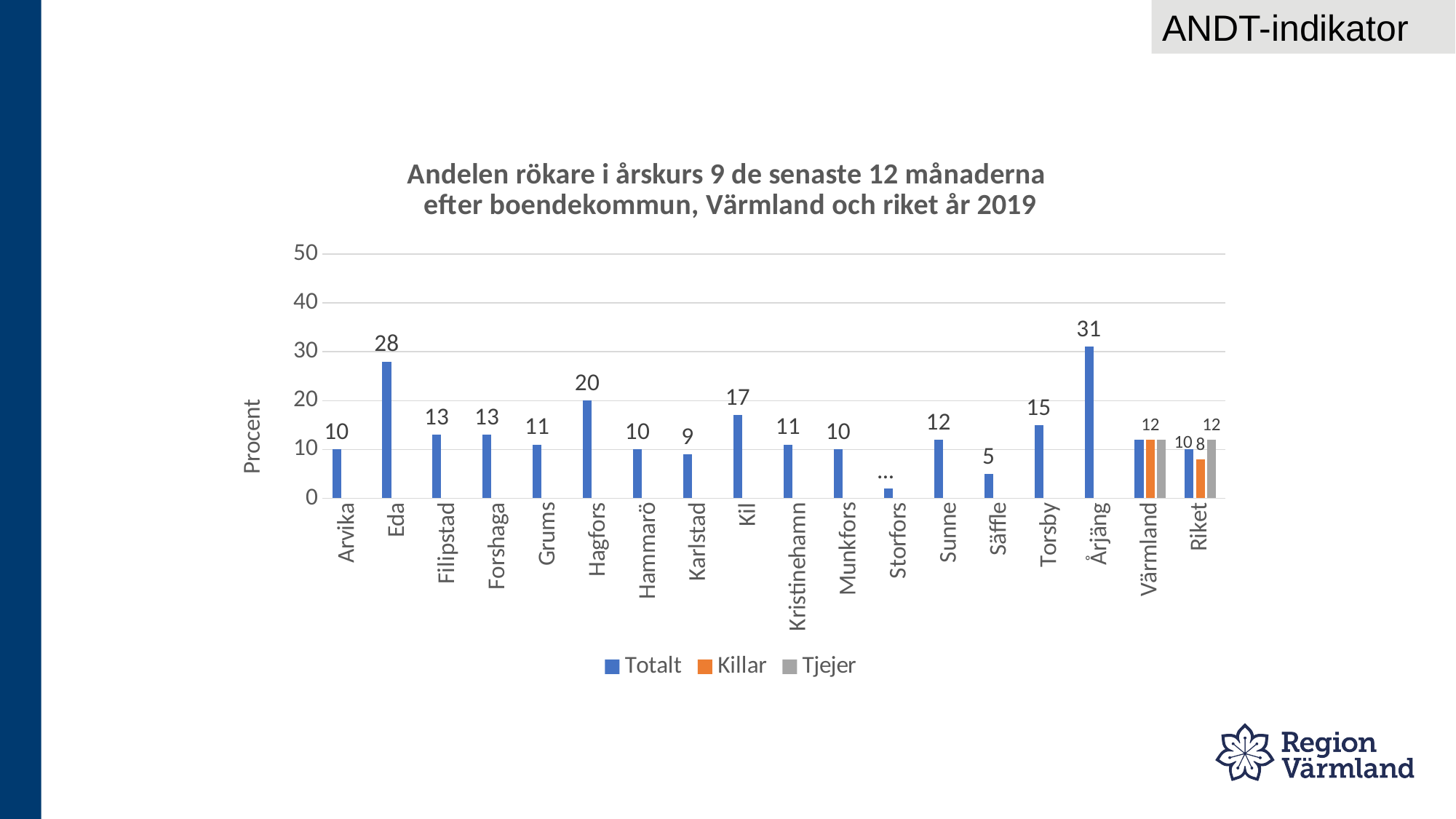
How many series does the legend list? 3 What is the Killar value for Riket? 8 Is the value for Säffle greater or less than 10? less Which is larger, the value for Torsby or the value for Sunne? Torsby For Riket, what is the difference between the Tjejer and Killar values? 4 Which municipality has the highest value? Årjäng What is the difference between the values for Årjäng and Eda? 3 What is the Tjejer value for Riket? 12 How many categories are shown on the x axis? 18 What kind of chart is shown? bar chart What is the value for Hagfors? 20 What is the value for Eda? 28